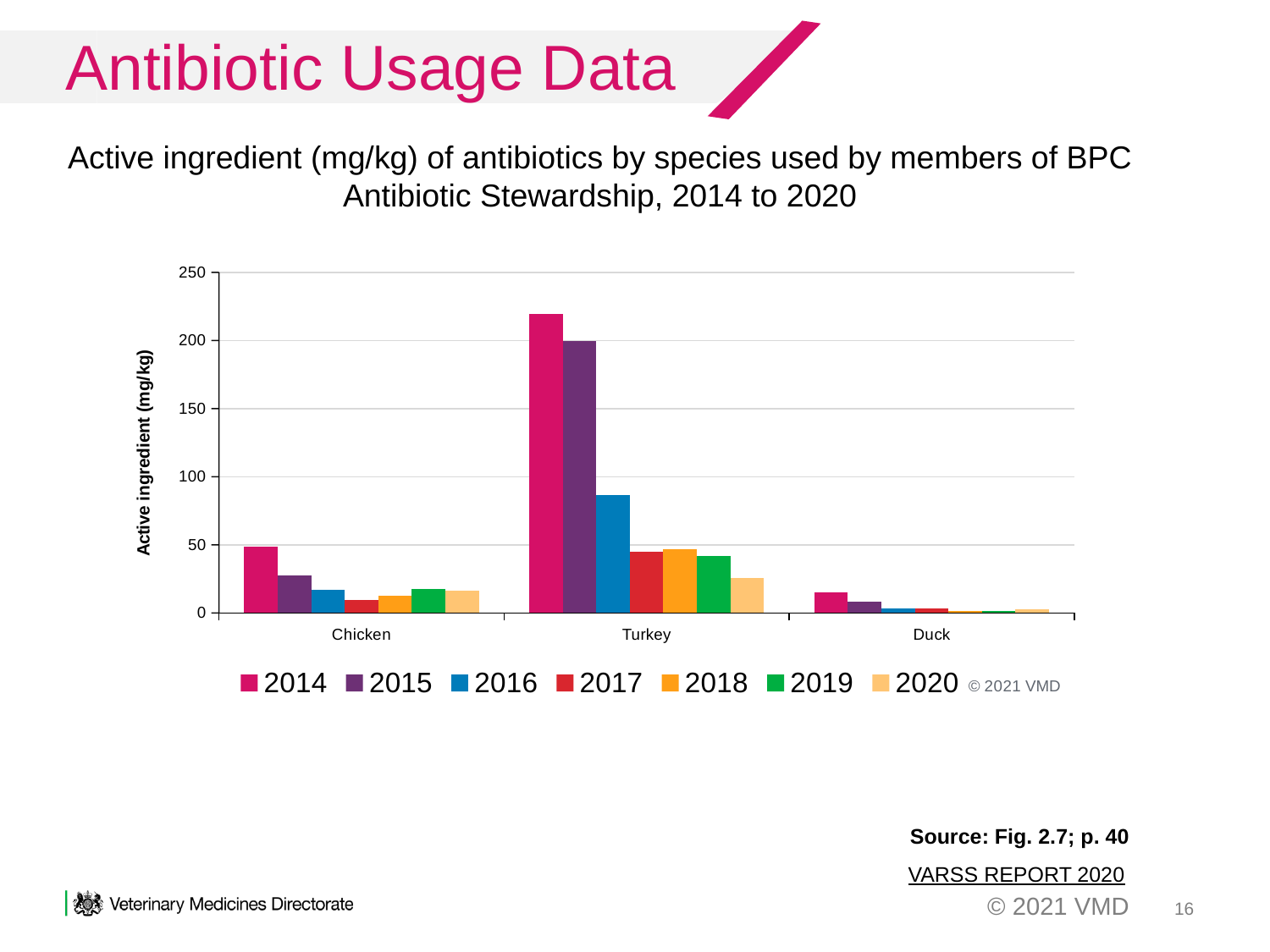
What is the label on the y axis of the chart? Active ingredient (mg/kg) How many species categories are shown on the x axis of the chart? 3 How many series (years) does the chart legend list? 7 Is the value for Turkey in 2014 greater or less than 200? greater For Turkey, do the values rise or fall from 2014 to 2017? fall Which species has the highest value for 2014? Turkey For Chicken, which year has the larger value, 2014 or 2015? 2014 For Turkey, which year has the larger value, 2014 or 2015? 2014 Which species has the lowest value for 2014? Duck Is the value for Turkey in 2016 greater or less than 100? less What kind of chart is shown on the slide? bar chart